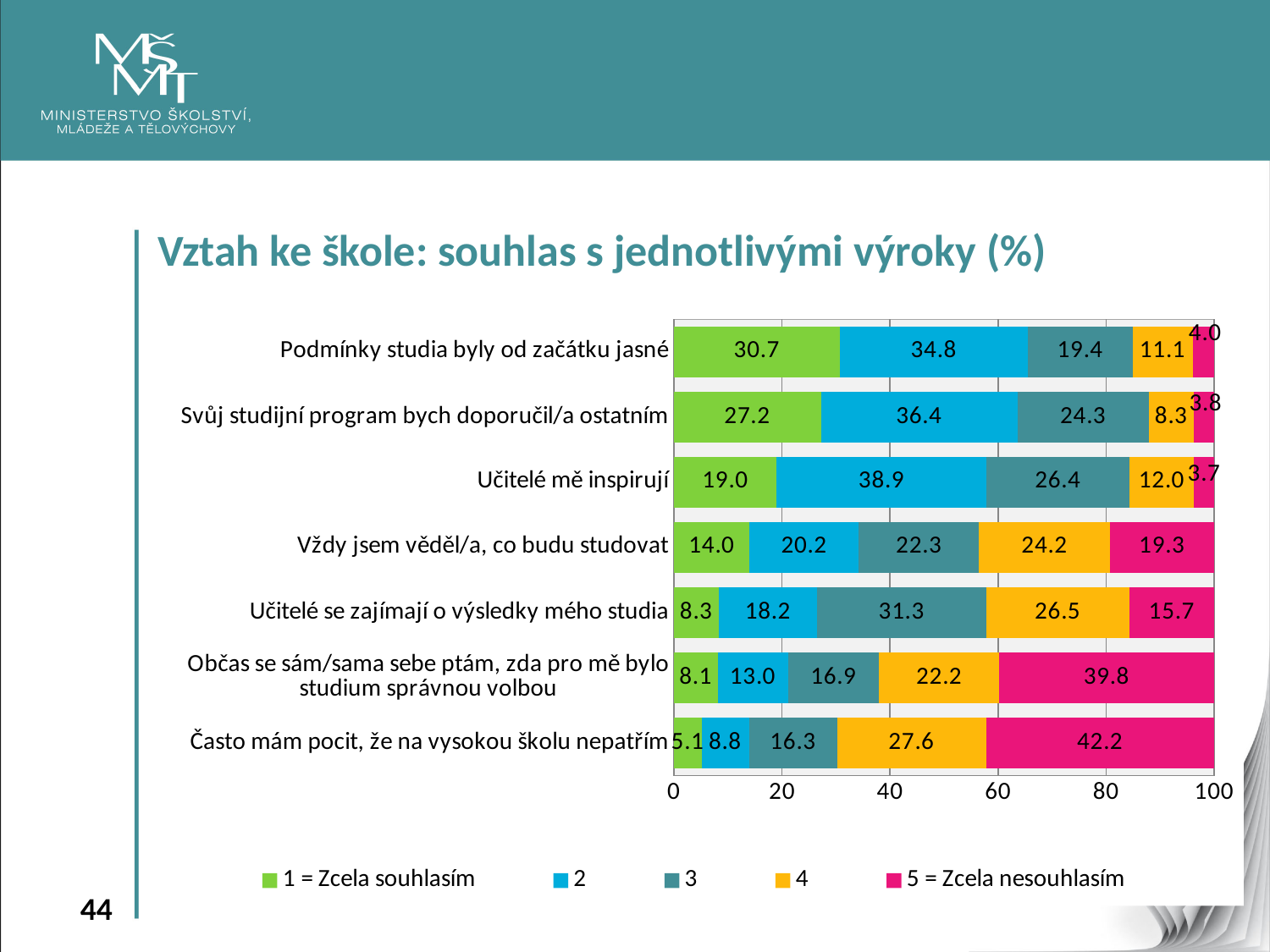
How many statements (categories) are shown in the chart? 7 What is the title of the chart? Vztah ke škole: souhlas s jednotlivými výroky (%) What is the difference between the '5 = Zcela nesouhlasím' values for 'Často mám pocit, že na vysokou školu nepatřím' and 'Občas se sám/sama sebe ptám, zda pro mě bylo studium správnou volbou'? 2.4 Which is larger: the series '3' value for 'Učitelé se zajímají o výsledky mého studia' or for 'Učitelé mě inspirují'? Učitelé se zajímají o výsledky mého studia What is the value of series '4' for 'Vždy jsem věděl/a, co budu studovat'? 24.2 What type of chart is shown on the slide? stacked bar chart What is the value of series '2' for 'Učitelé mě inspirují'? 38.9 Which statement has the lowest value for '5 = Zcela nesouhlasím'? Učitelé mě inspirují What is the value of '1 = Zcela souhlasím' for 'Podmínky studia byly od začátku jasné'? 30.7 What is the value of '5 = Zcela nesouhlasím' for 'Často mám pocit, že na vysokou školu nepatřím'? 42.2 How many series does the legend list? 5 Which statement has the highest value for '1 = Zcela souhlasím'? Podmínky studia byly od začátku jasné